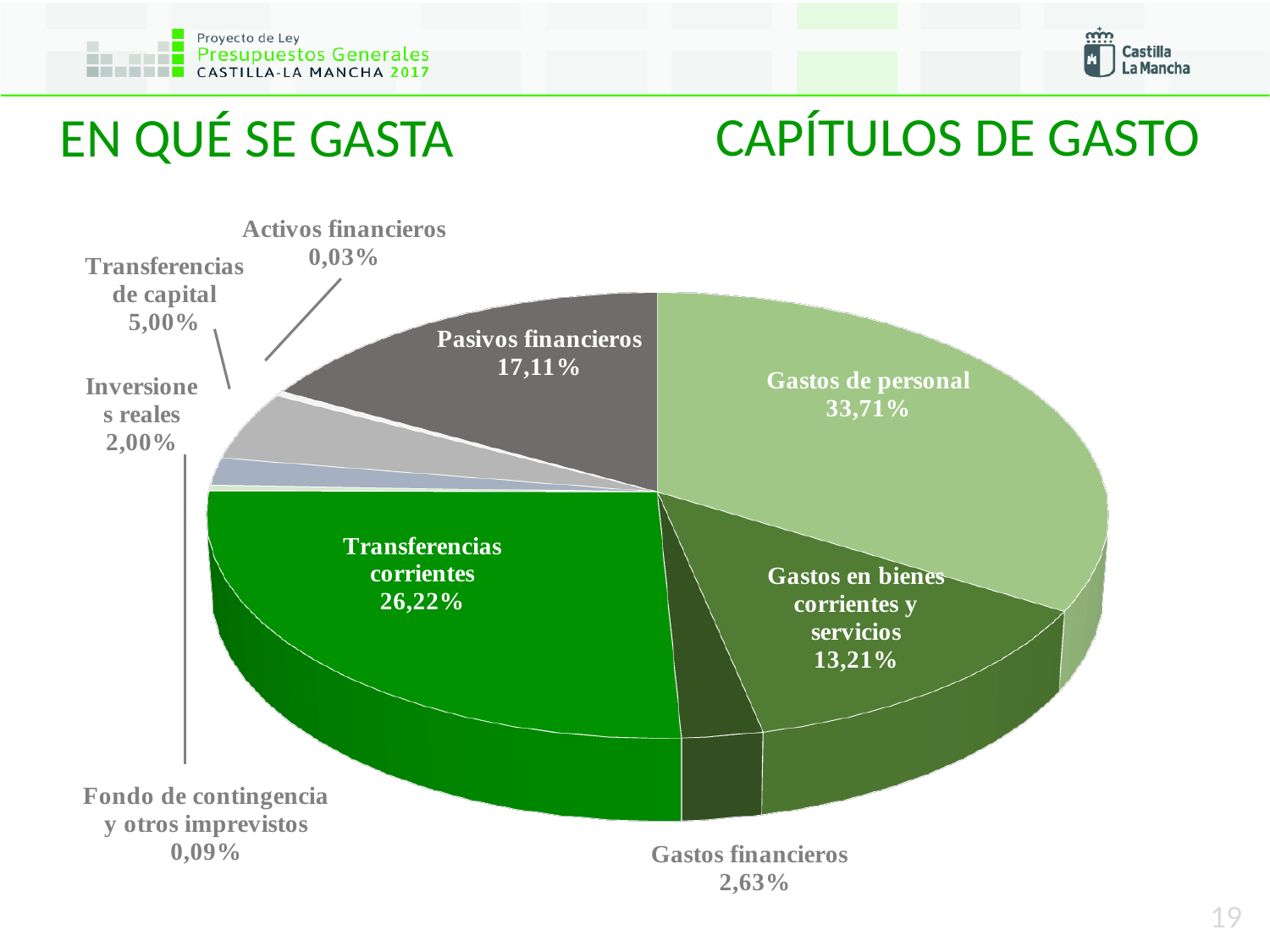
What is the value for Pasivos financieros? 17,11% What is the difference between the shares of Gastos de personal and Transferencias corrientes? 7,49% Which category has the largest share of the pie? Gastos de personal What is the difference between Transferencias de capital and Inversiones reales? 3,00% What kind of chart is shown on the slide? Pie chart What is the share for Fondo de contingencia y otros imprevistos? 0,09% What share of spending goes to Gastos de personal? 33,71% Which category has the smallest share of the pie? Activos financieros Which is larger, Pasivos financieros or Gastos en bienes corrientes y servicios? Pasivos financieros What percentage is shown for Transferencias corrientes? 26,22% How many categories are shown in the pie chart? 9 What percentage is labelled for Gastos en bienes corrientes y servicios? 13,21%